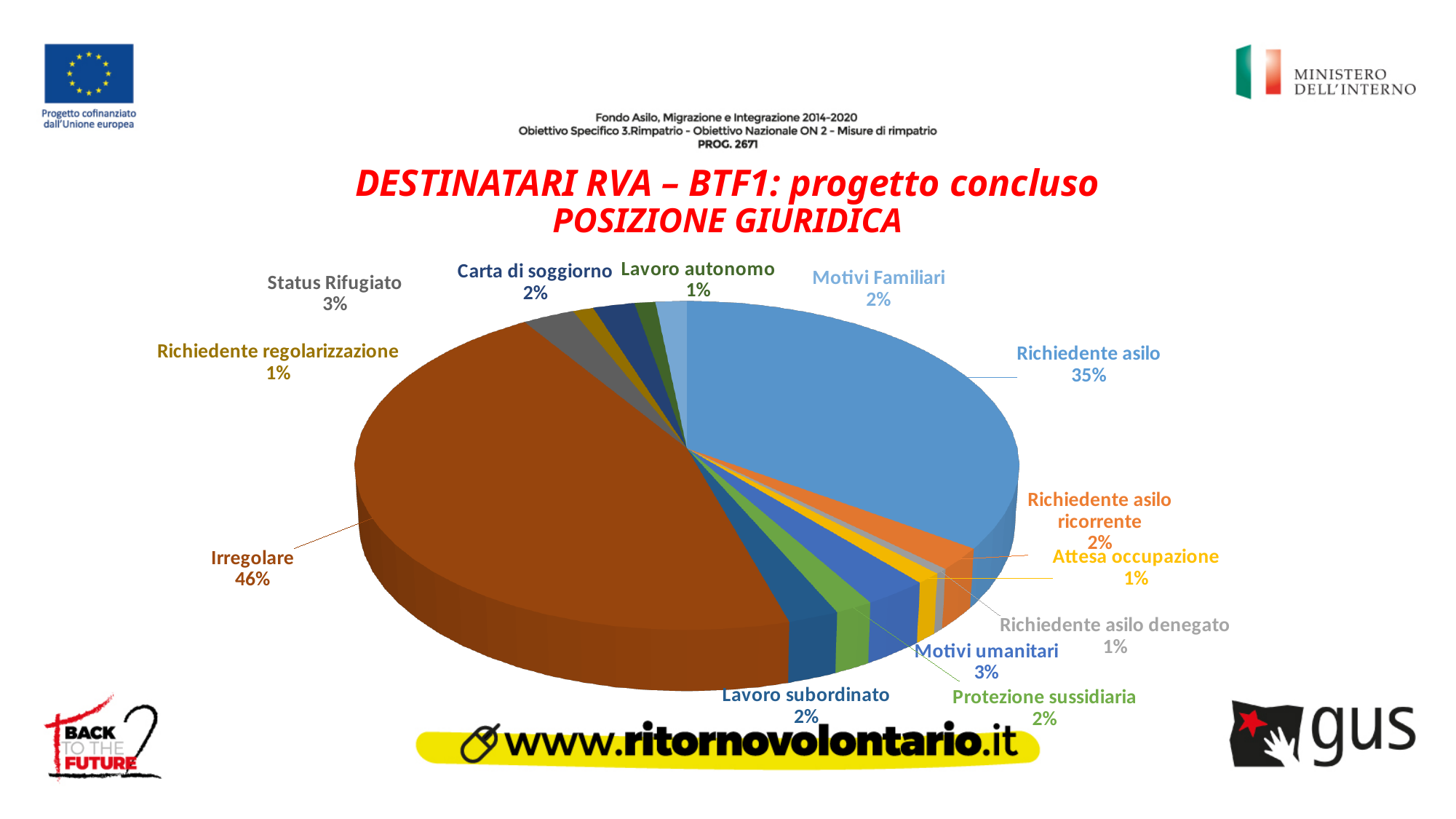
What percentage is shown for Protezione sussidiaria? 2% What percentage is shown for Richiedente asilo? 35% Which is larger, Richiedente asilo or Status Rifugiato? Richiedente asilo What is the subtitle of the chart below the red title? POSIZIONE GIURIDICA What kind of chart is shown on the slide? Pie chart Which is larger, Motivi umanitari or Lavoro subordinato? Motivi umanitari What is the value for Attesa occupazione? 1% How many categories are shown in the pie chart? 13 What is the value for Status Rifugiato? 3% Which category has the largest slice of the pie? Irregolare What is the difference in percentage points between Irregolare and Richiedente asilo? 11 What share of the pie does Irregolare represent? 46%